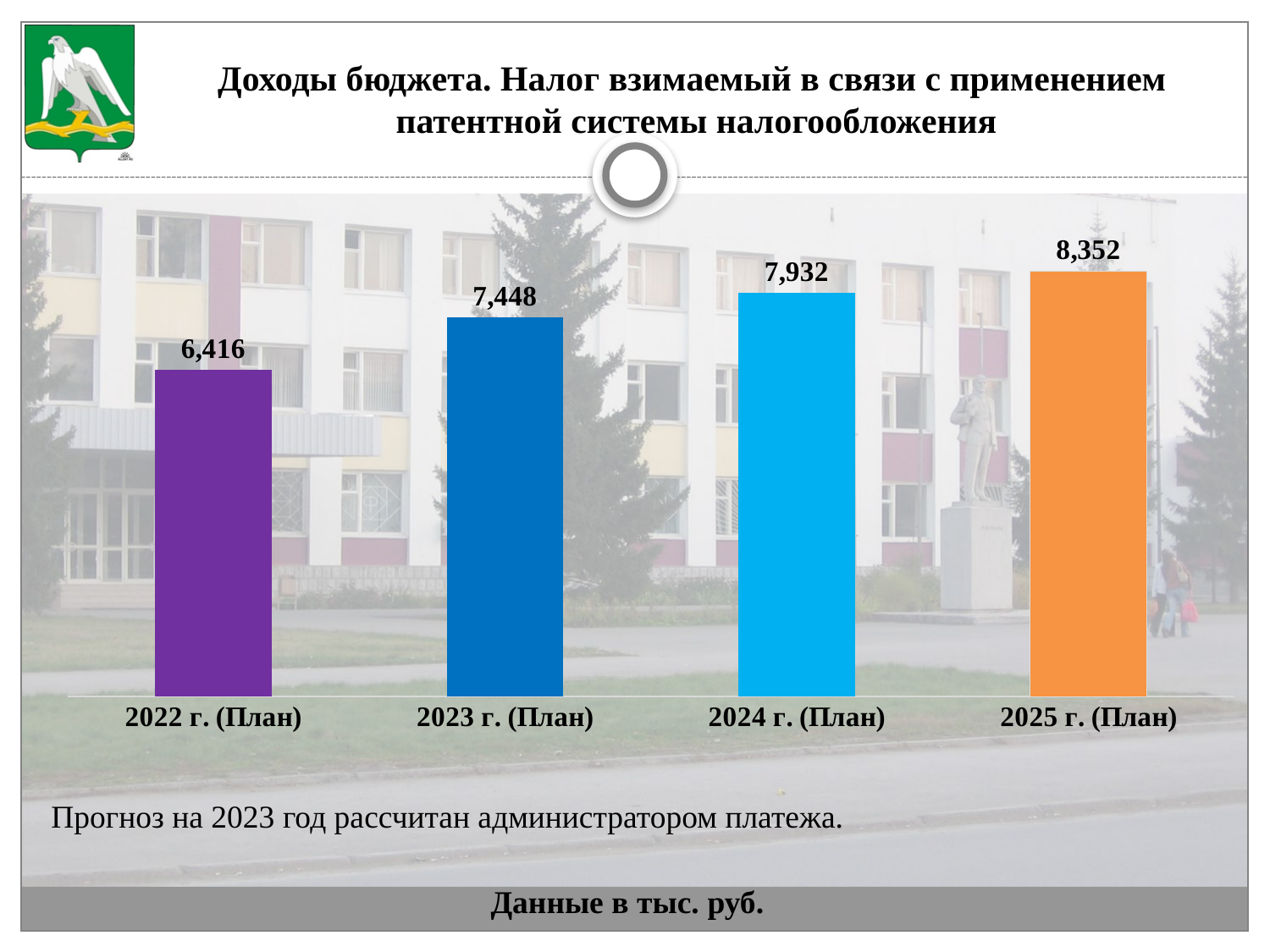
What is the value for 2022 г. (План)? 6,416 What is the difference between the values for 2023 г. (План) and 2022 г. (План)? 1,032 What kind of chart is shown on the slide? Bar chart Which category has the highest value? 2025 г. (План) How many categories are shown in the chart? 4 Which category has the lowest value? 2022 г. (План) What is the difference between the values for 2025 г. (План) and 2024 г. (План)? 420 Which is larger, the value for 2024 г. (План) or the value for 2023 г. (План)? 2024 г. (План) Do the values rise or fall from 2022 г. (План) to 2025 г. (План)? Rise What is the value for 2023 г. (План)? 7,448 What is the value for 2025 г. (План)? 8,352 What is the value for 2024 г. (План)? 7,932